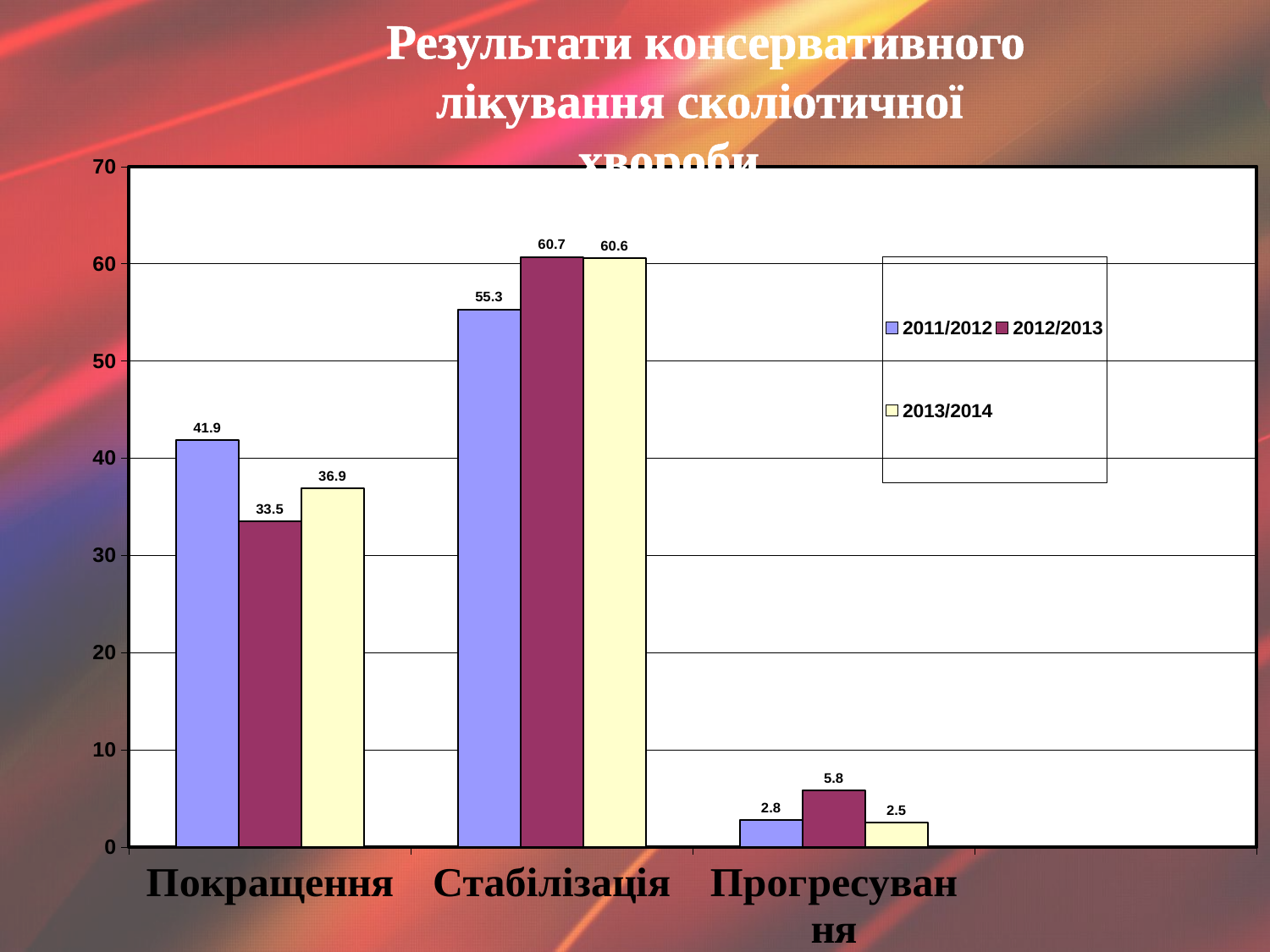
Is the value for 2011/2012 in the Стабілізація category greater or less than 50? greater What is the value for 2013/2014 in the Прогресування category? 2.5 In the Прогресування category, which series has the larger value: 2012/2013 or 2013/2014? 2012/2013 Which series is shown in the pale yellow colour in the legend? 2013/2014 How many series does the legend list? 3 What kind of chart is shown on the slide? bar chart Which category has the lowest value for the 2011/2012 series? Прогресування Which category has the highest value for the 2013/2014 series? Стабілізація What is the difference between the 2011/2012 and 2012/2013 values in the Покращення category? 8.4 What is the value for 2012/2013 in the Стабілізація category? 60.7 How many categories are shown on the x axis? 3 What is the value for 2011/2012 in the Покращення category? 41.9